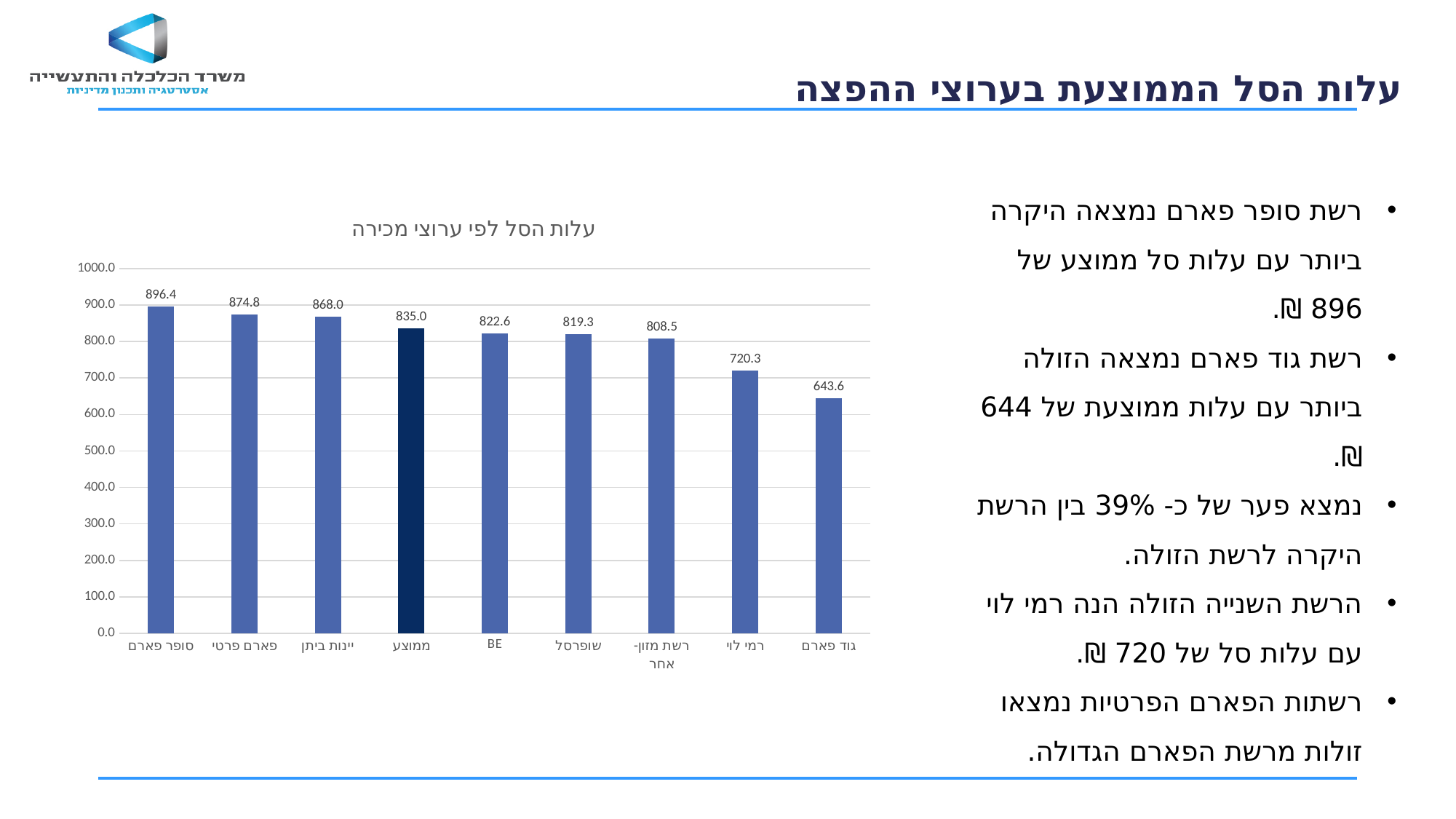
Is the value for רמי לוי greater or less than 800.0? less What is the value for רמי לוי in the chart? 720.3 What is the value for ממוצע in the chart? 835.0 Which is larger, the value for BE or the value for שופרסל? BE What kind of chart is shown on the slide? bar chart How many bars are shown in the chart? 9 What is the title of the chart? עלות הסל לפי ערוצי מכירה What is the difference between the values for סופר פארם and גוד פארם? 252.8 What is the value for סופר פארם in the chart? 896.4 What is the value for גוד פארם in the chart? 643.6 Which category has the highest value in the chart? סופר פארם Which category has the lowest value in the chart? גוד פארם